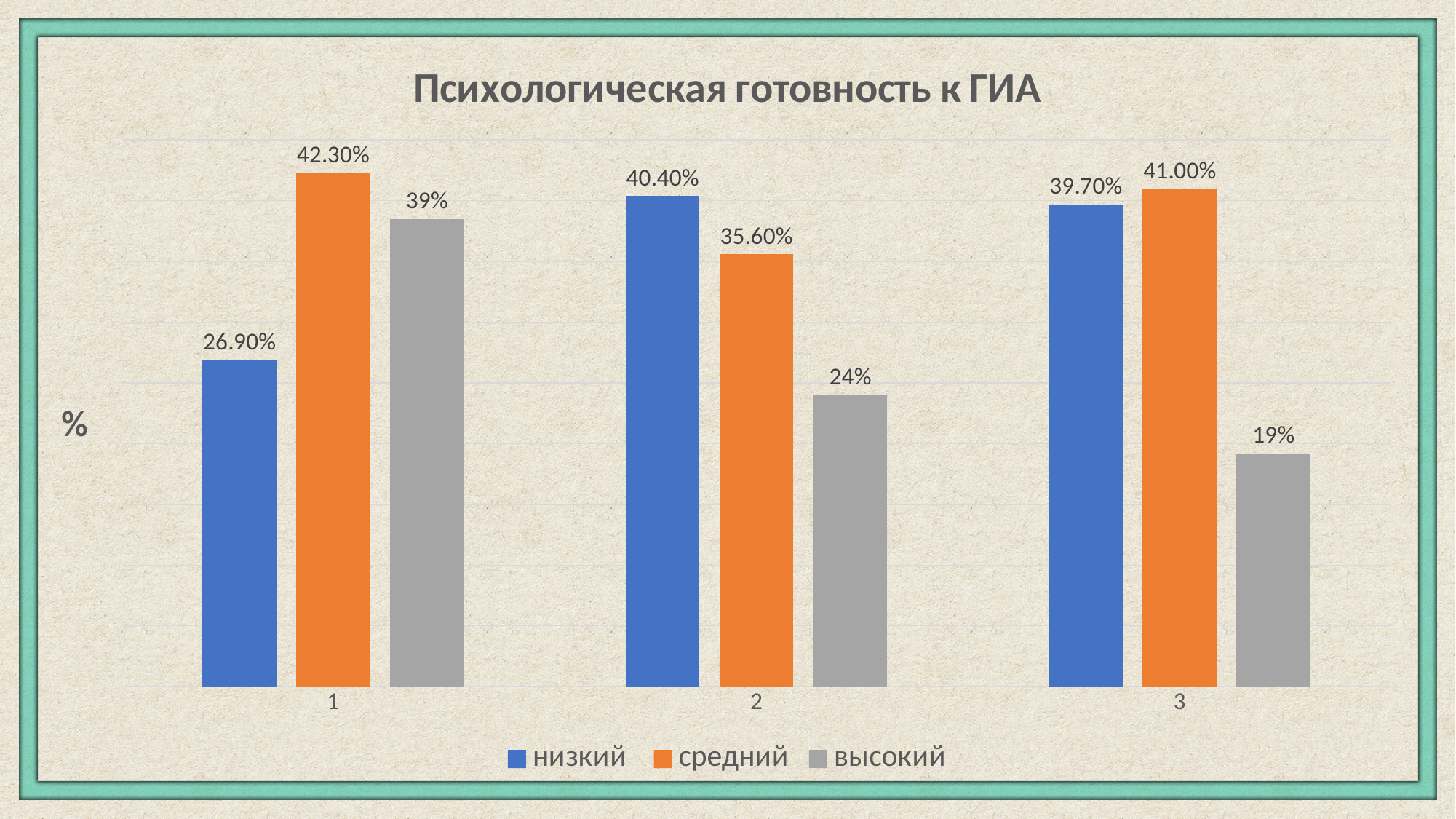
What is the value for высокий in category 3? 19% Which category has the highest value for средний? 1 Which category has the lowest value for высокий? 3 What is the title of the chart? Психологическая готовность к ГИА What is the difference between the высокий values in category 1 and category 3? 20% What is the difference between the средний and низкий values in category 1? 15.40% What is the value for низкий in category 1? 26.90% How many categories are shown on the x axis? 3 What is the value for средний in category 2? 35.60% Which is larger in category 2: низкий or средний? низкий What kind of chart is shown on the slide? bar chart How many series does the legend list? 3